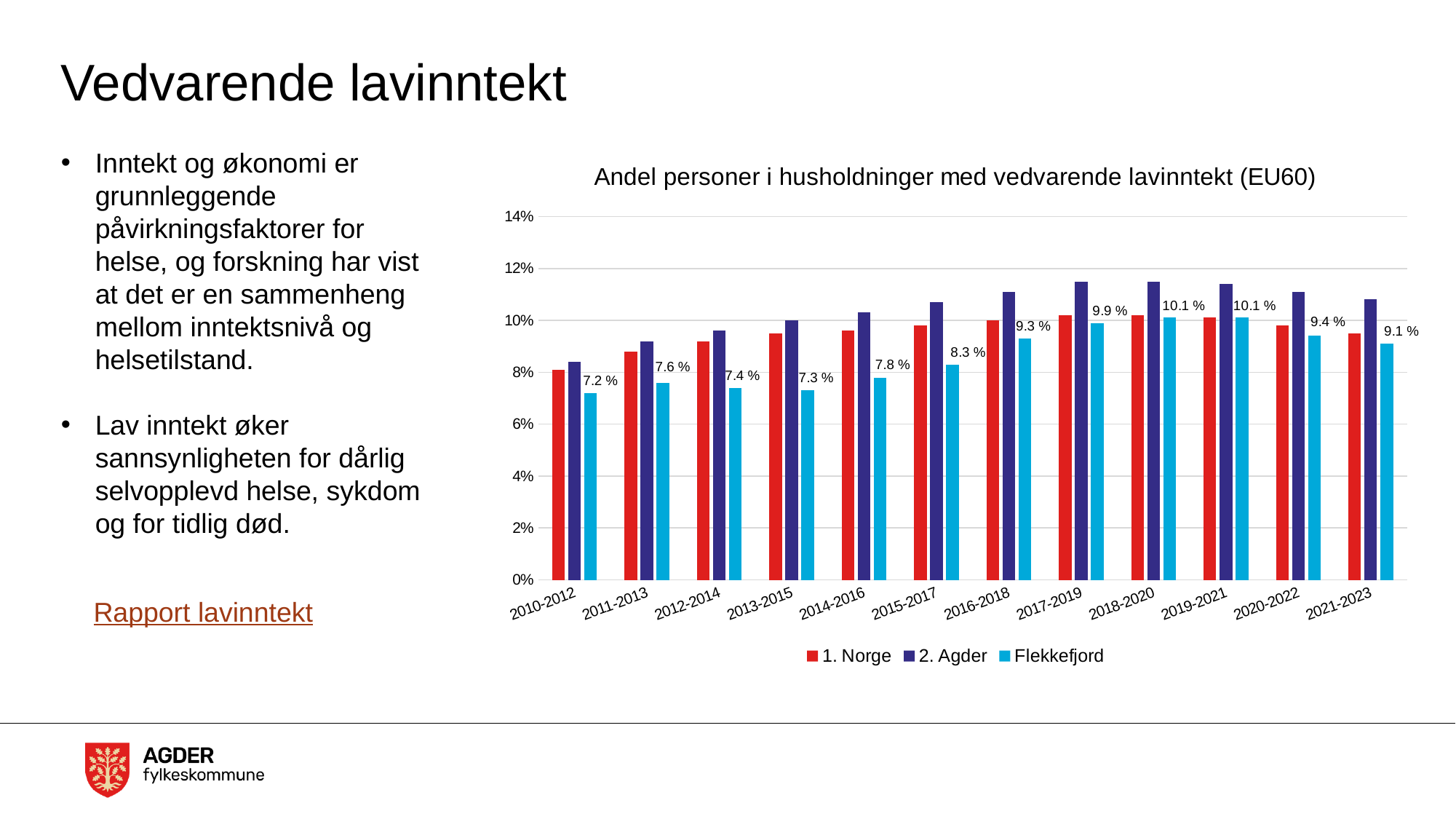
In which period is the Flekkefjord value lowest? 2010-2012 What is the value for Flekkefjord in 2010-2012? 7.2 % What is the value for Flekkefjord in 2017-2019? 9.9 % Is the value for 2. Agder in 2017-2019 greater or less than 10%? greater Which is larger in 2016-2018, the value for 1. Norge or for 2. Agder? 2. Agder Do the Flekkefjord values rise or fall from 2013-2015 to 2018-2020? Rise What is the value for Flekkefjord in 2021-2023? 9.1 % What is the difference between the Flekkefjord values for 2021-2023 and 2010-2012? 1.9 percentage points Is the value for 1. Norge in 2010-2012 greater or less than 10%? less How many series does the legend list? 3 How many periods are shown on the x axis? 12 What kind of chart is shown on the slide? Bar chart